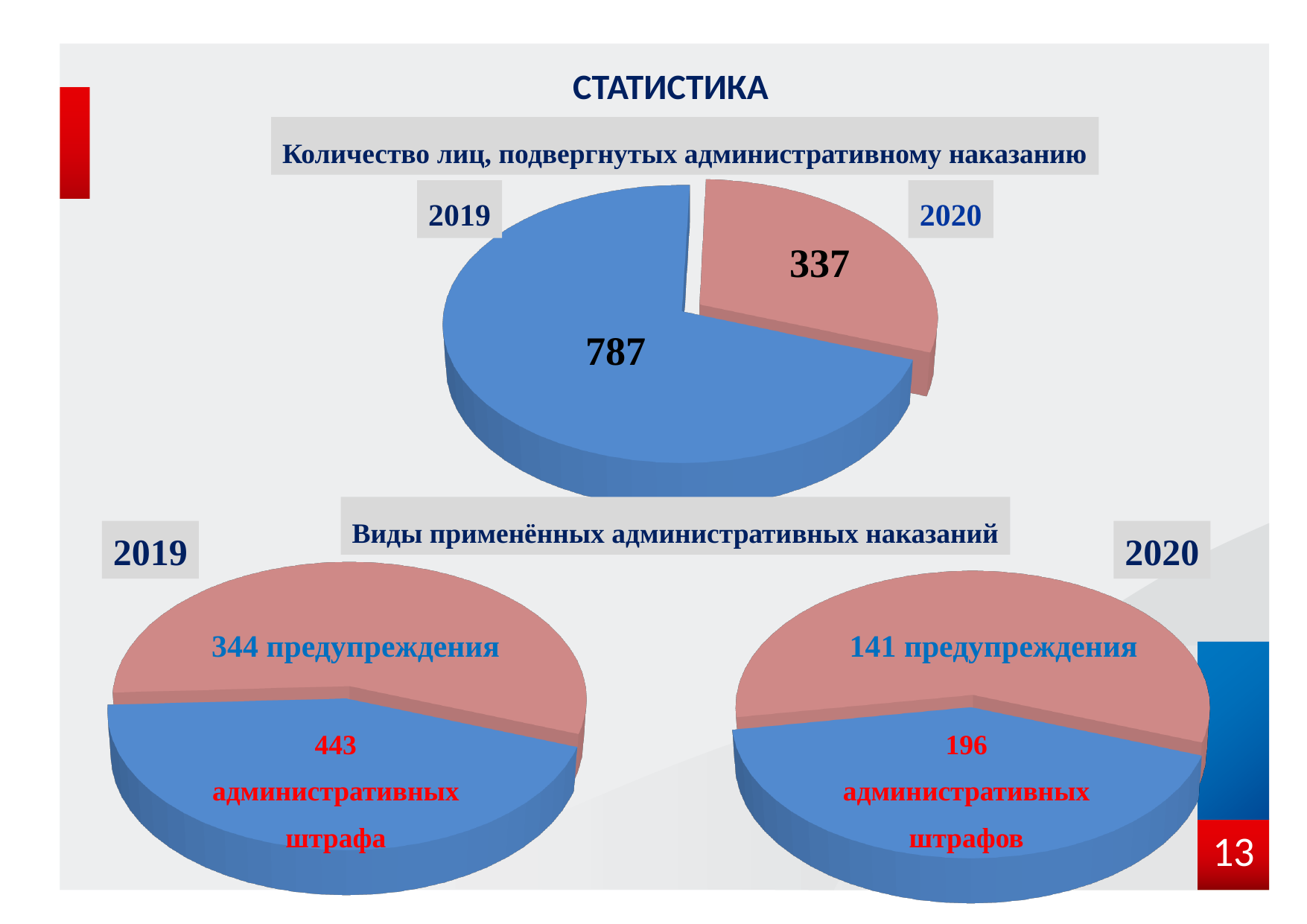
In the top pie chart 'Количество лиц, подвергнутых административному наказанию', what is the value for 2019? 787 In the top pie chart 'Количество лиц, подвергнутых административному наказанию', what is the value for 2020? 337 In the bottom-right pie chart (2020), which category is larger, предупреждения or административных штрафов? административных штрафов In the top pie chart, what is the total of the two slices? 1124 In the top pie chart, what is the difference between the 2019 and 2020 values? 450 In the top pie chart, which year has the larger slice, 2019 or 2020? 2019 In the bottom-left pie chart (2019), how many административных штрафа are shown? 443 In the top pie chart, what share of the total does the 2019 slice represent, to the nearest percent? 70% In the bottom-right pie chart (2020), what is the difference between административных штрафов and предупреждения? 55 What type of chart is used for the three charts on the slide? Pie chart In the bottom-right pie chart (2020), how many предупреждения are shown? 141 In the bottom-left pie chart (2019, 'Виды применённых административных наказаний'), how many предупреждения are shown? 344